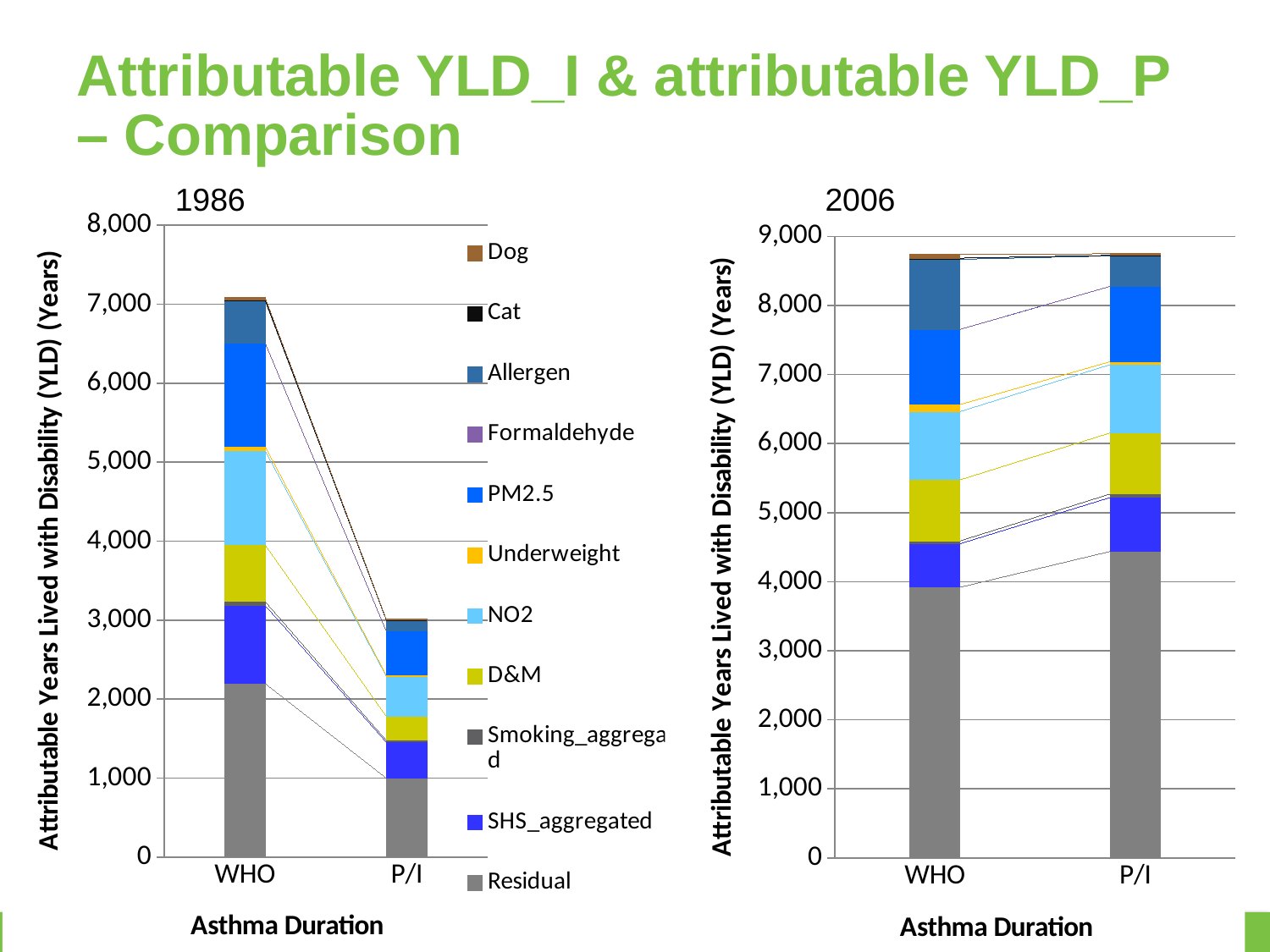
In the 1986 chart, is the Residual value for WHO greater or less than 2,000? greater In the 1986 chart, is the total for WHO greater or less than 6,000? greater Which series is shown at the bottom of each stacked bar, according to the legend? Residual In the 1986 chart, do the stacked totals rise or fall from WHO to P/I? fall How many series does the legend list? 11 In the 1986 chart, which category has the taller stacked bar, WHO or P/I? WHO What kind of chart is the 1986 chart on the left? stacked bar chart In the 1986 chart, is the total for P/I greater or less than 4,000? less What is the x-axis title of the 2006 chart? Asthma Duration How many categories are shown on the x axis of the 2006 chart? 2